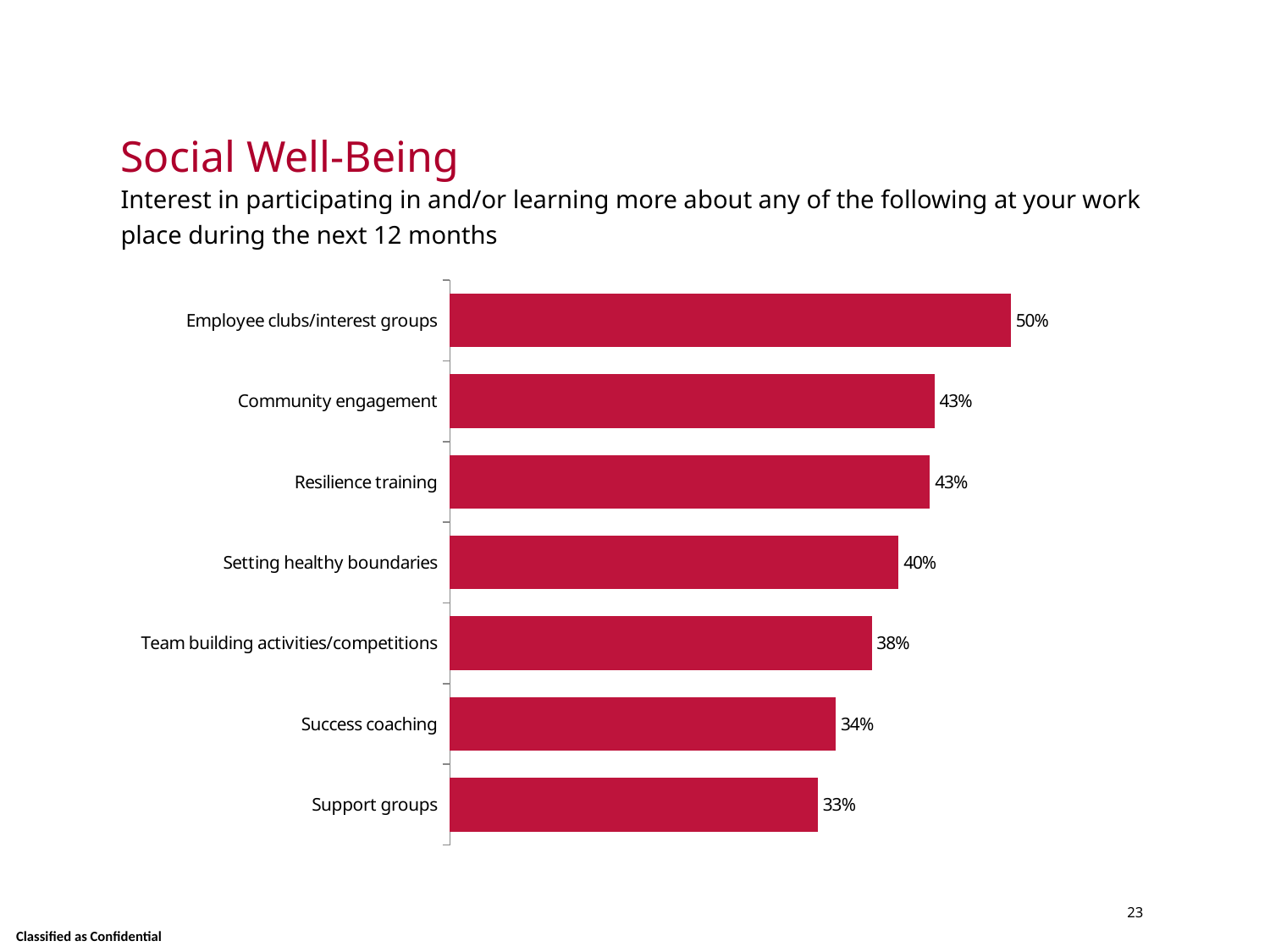
What is the value for Success coaching? 34% What is the difference between the values for Employee clubs/interest groups and Support groups? 17% How many categories are shown in the chart? 7 Which category has the highest value? Employee clubs/interest groups Which category has the lowest value? Support groups What kind of chart is shown on the slide? Bar chart What is the title of the slide? Social Well-Being Which is larger, the value for Setting healthy boundaries or the value for Success coaching? Setting healthy boundaries What is the difference between the values for Community engagement and Team building activities/competitions? 5% What is the value for Setting healthy boundaries? 40% What is the value for Support groups? 33% What is the value for Employee clubs/interest groups? 50%